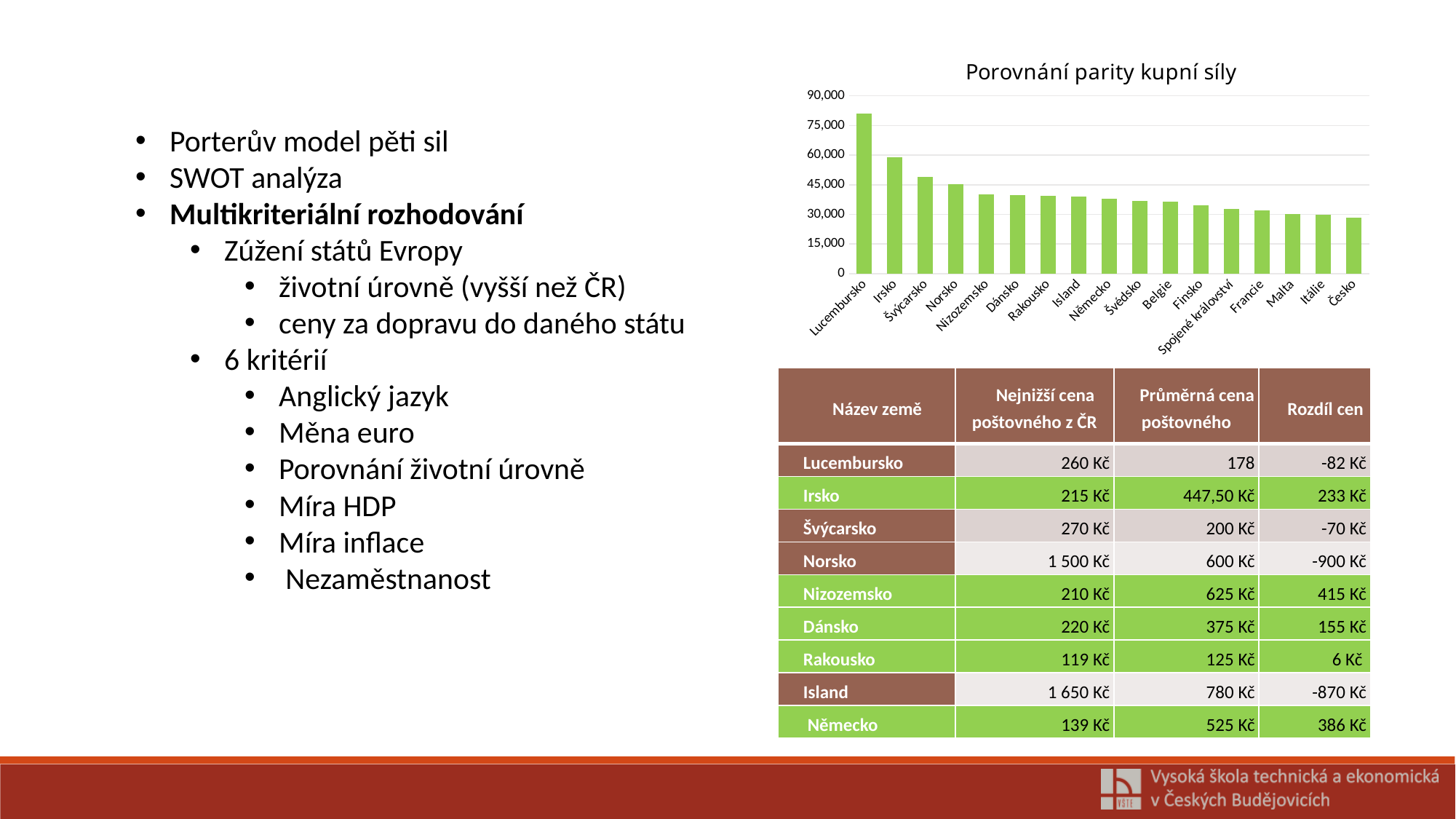
Which country has the lowest value in the chart? Česko How many countries are shown in the chart? 17 Which has a larger value, Finsko or Lucembursko? Lucembursko What kind of chart is shown on the slide? bar chart Do the values rise or fall from left to right along the x axis? fall Is the value for Irsko greater or less than 45,000? greater Is the value for Česko greater or less than 30,000? less What is the title of the chart? Porovnání parity kupní síly Is the value for Lucembursko greater or less than 75,000? greater Which has a larger value, Irsko or Švýcarsko? Irsko Which country has the highest value in the chart? Lucembursko